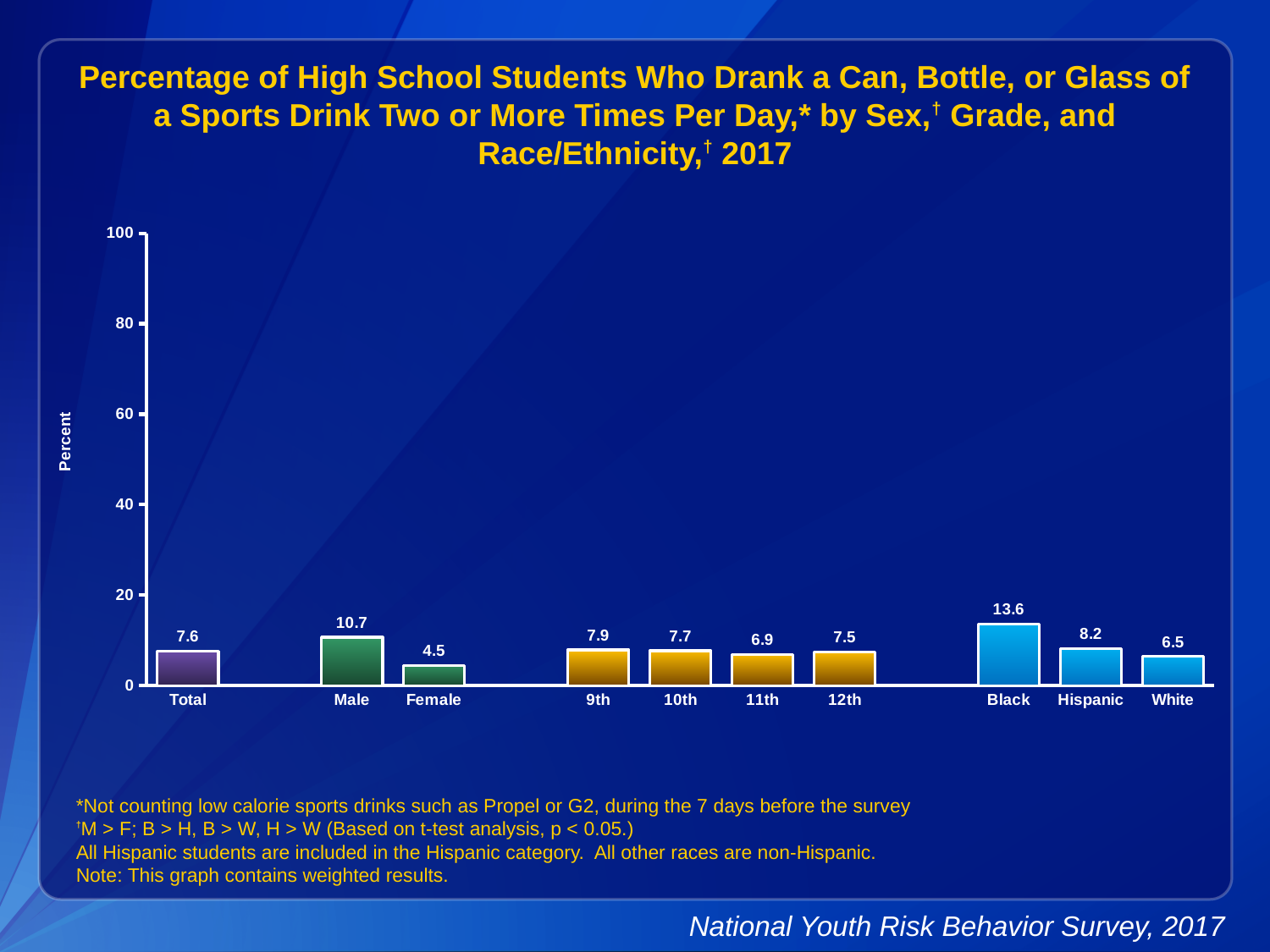
What is the difference between the values for Male and Female? 6.2 How many categories are shown on the x axis? 10 Is the value for Total greater or less than 20? less Which is larger, the value for Black or the value for White? Black What is the value for Hispanic? 8.2 Which category has the highest value? Black What kind of chart is this? bar chart What is the label of the y axis? Percent What is the value for 11th grade? 6.9 Which category has the lowest value? Female What is the value for Male? 10.7 What is the difference between the values for Black and Hispanic? 5.4